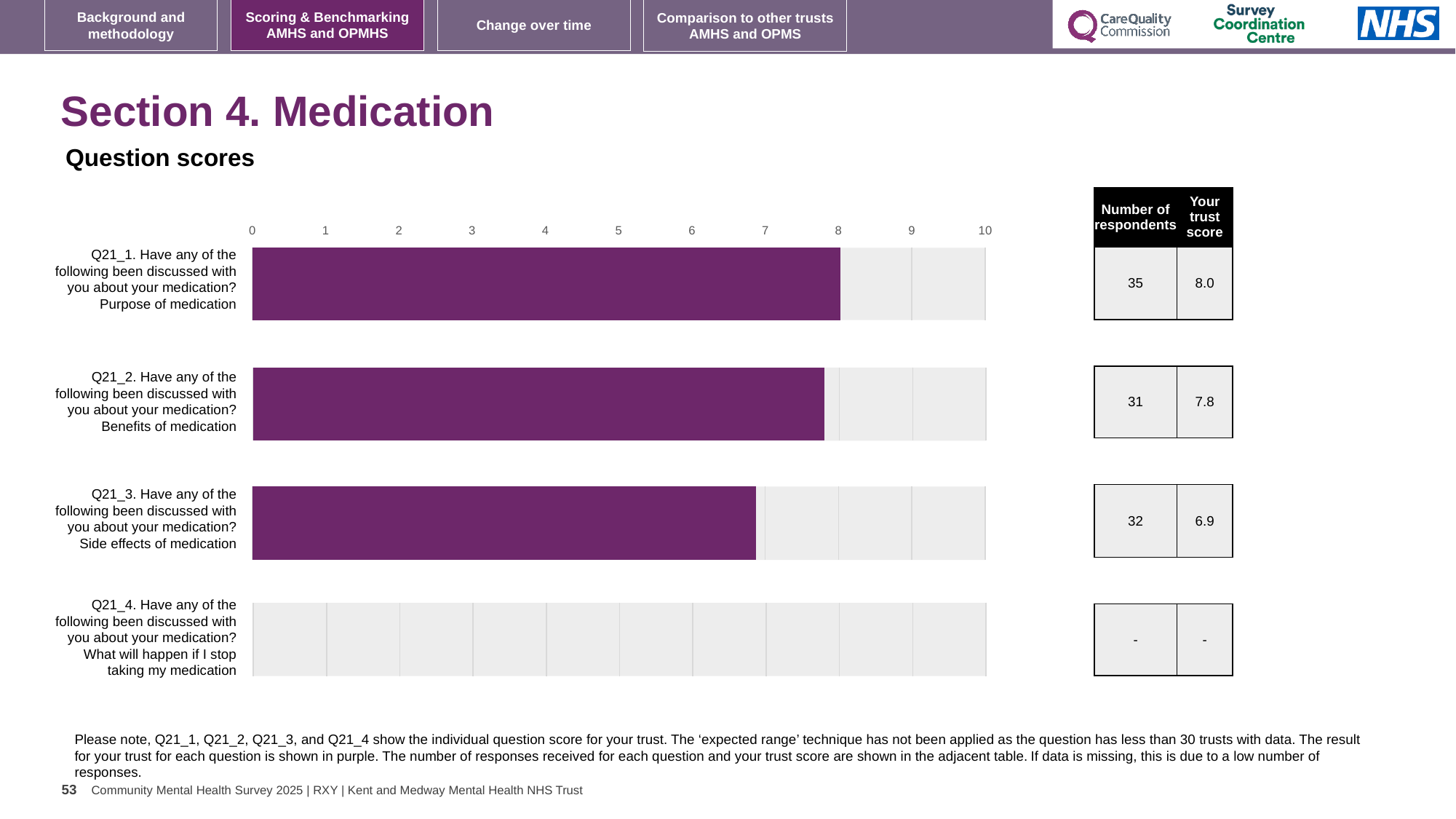
Is the trust score for Q21_3 (Side effects of medication) greater or less than 7? less What is the difference between the trust scores for Q21_1 (Purpose of medication) and Q21_3 (Side effects of medication)? 1.1 What is the trust score shown for Q21_4 (What will happen if I stop taking my medication)? - What is the maximum value shown on the chart's axis? 10 Among the questions with a score shown, which has the lowest trust score? Q21_3. Side effects of medication Which question has the highest trust score? Q21_1. Purpose of medication What is the trust score for Q21_3 (Side effects of medication)? 6.9 Which has a higher trust score, Q21_2 (Benefits of medication) or Q21_3 (Side effects of medication)? Q21_2. Benefits of medication How many respondents answered Q21_2 (Benefits of medication)? 31 What kind of chart is shown on the slide? Bar chart What is the trust score for Q21_1 (Purpose of medication)? 8.0 How many questions are listed on the chart? 4